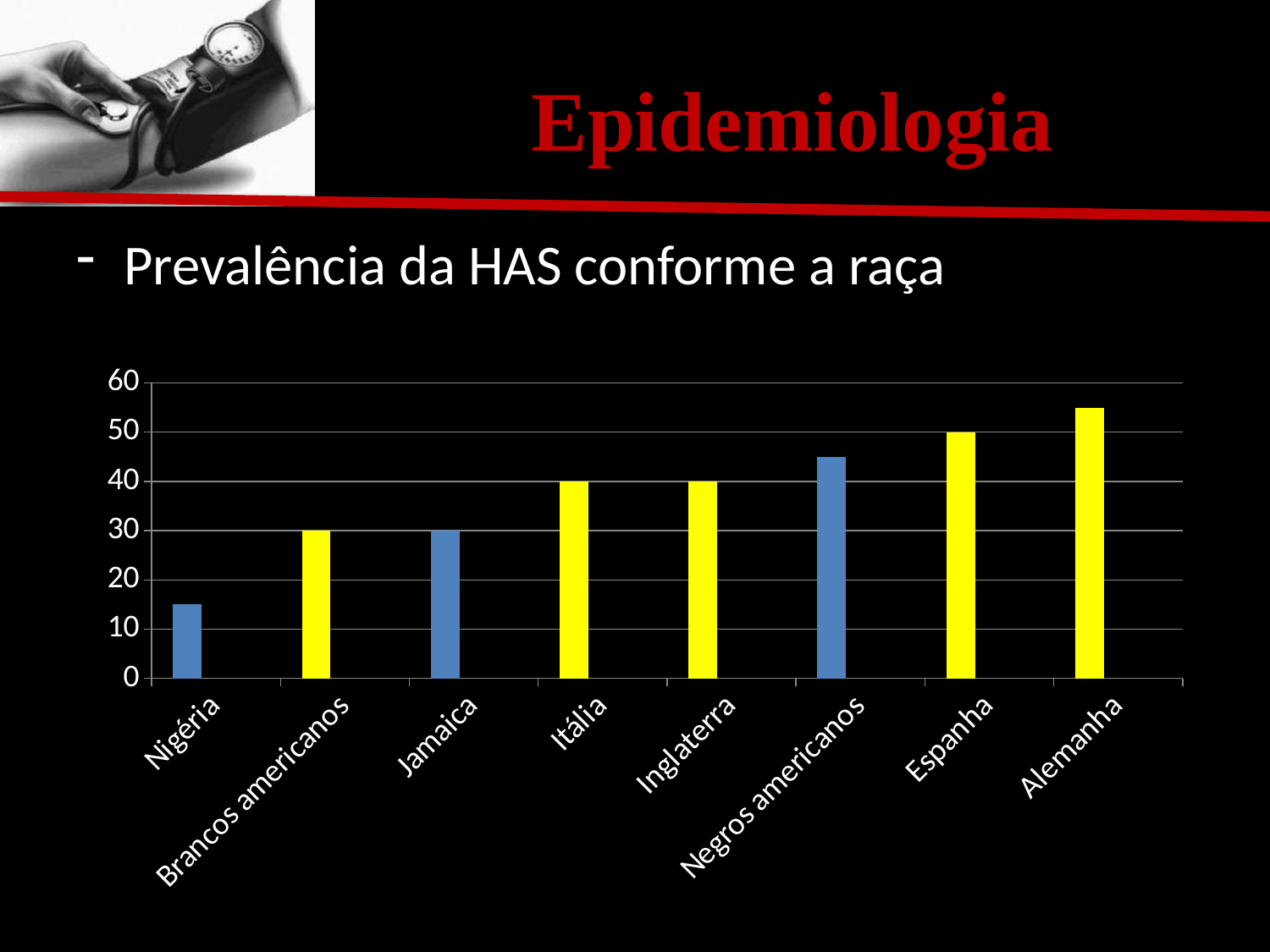
Do the bar values generally rise or fall from left to right along the x axis? rise What is the value for Itália in the chart? 40 Is the value for Alemanha greater or less than 50? greater Is the value for Nigéria greater or less than 20? less What kind of chart is shown on the slide? bar chart Which is larger, the value for Espanha or the value for Brancos americanos? Espanha How many categories are shown on the x axis of the chart? 8 Which category has the lowest bar in the chart? Nigéria What is the value for Jamaica in the chart? 30 What is the difference between the values for Espanha and Jamaica? 20 What is the value for Espanha in the chart? 50 Which category has the highest bar in the chart? Alemanha